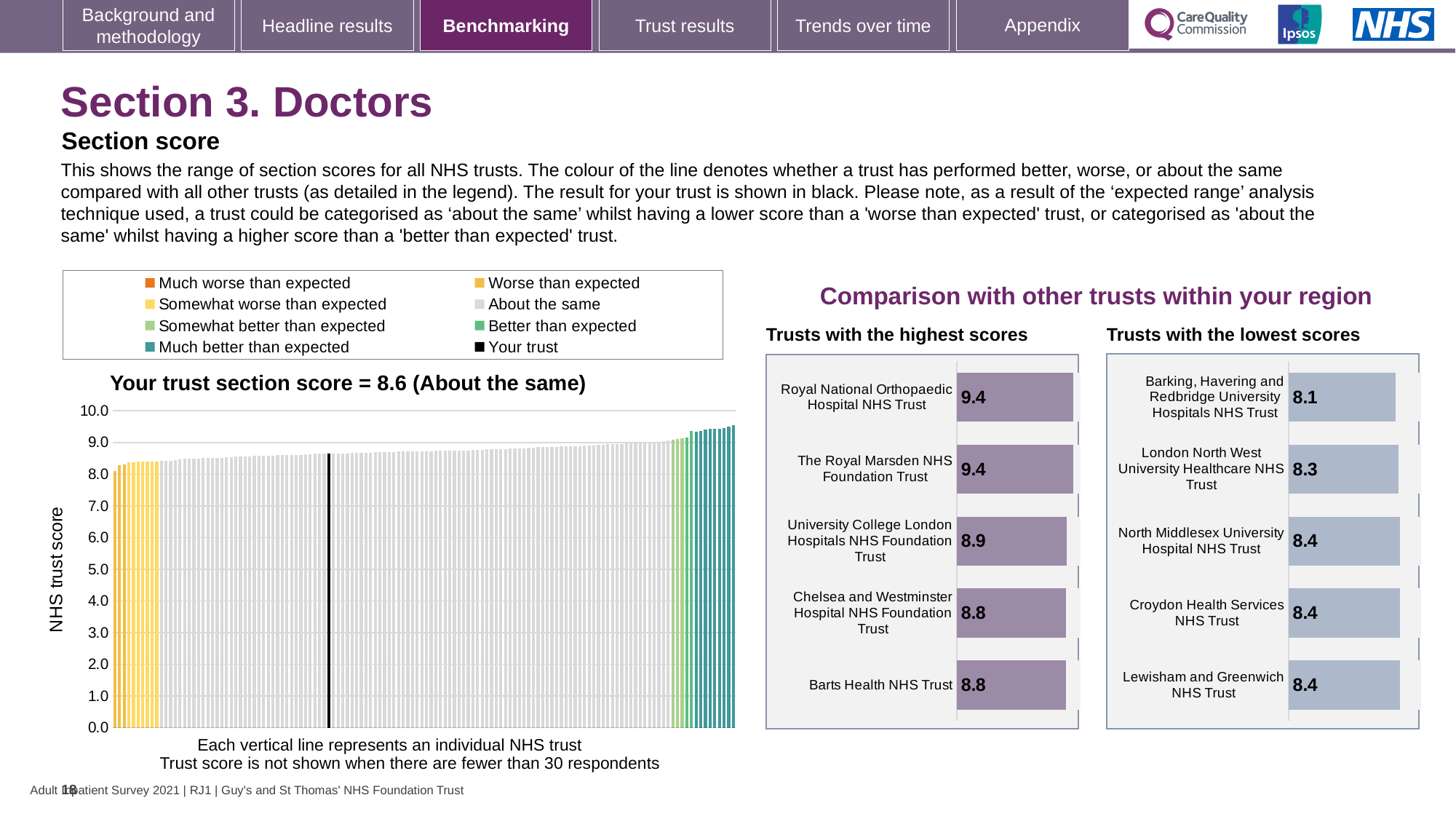
In the 'Your trust section score' chart, what is the section score for your trust? 8.6 In the 'Trusts with the lowest scores' chart, what is the score for London North West University Healthcare NHS Trust? 8.3 In the 'Trusts with the highest scores' chart, how many trusts are shown? 5 In the 'Trusts with the highest scores' chart, what is the score for Barts Health NHS Trust? 8.8 How many entries does the legend above the 'Your trust section score' chart list? 8 In the 'Your trust section score' chart, do the trust scores rise or fall from left to right along the x axis? Rise In the 'Trusts with the lowest scores' chart, which trust has the lowest score? Barking, Havering and Redbridge University Hospitals NHS Trust In the 'Trusts with the highest scores' chart, what is the score for University College London Hospitals NHS Foundation Trust? 8.9 In the 'Trusts with the lowest scores' chart, which is larger: the score for Croydon Health Services NHS Trust or the score for Barking, Havering and Redbridge University Hospitals NHS Trust? Croydon Health Services NHS Trust In the 'Trusts with the highest scores' chart, what is the difference between the score for Royal National Orthopaedic Hospital NHS Trust and the score for Barts Health NHS Trust? 0.6 In the 'Your trust section score' chart, how is your trust's score categorised? About the same What kind of chart is the 'Your trust section score' chart? Bar chart